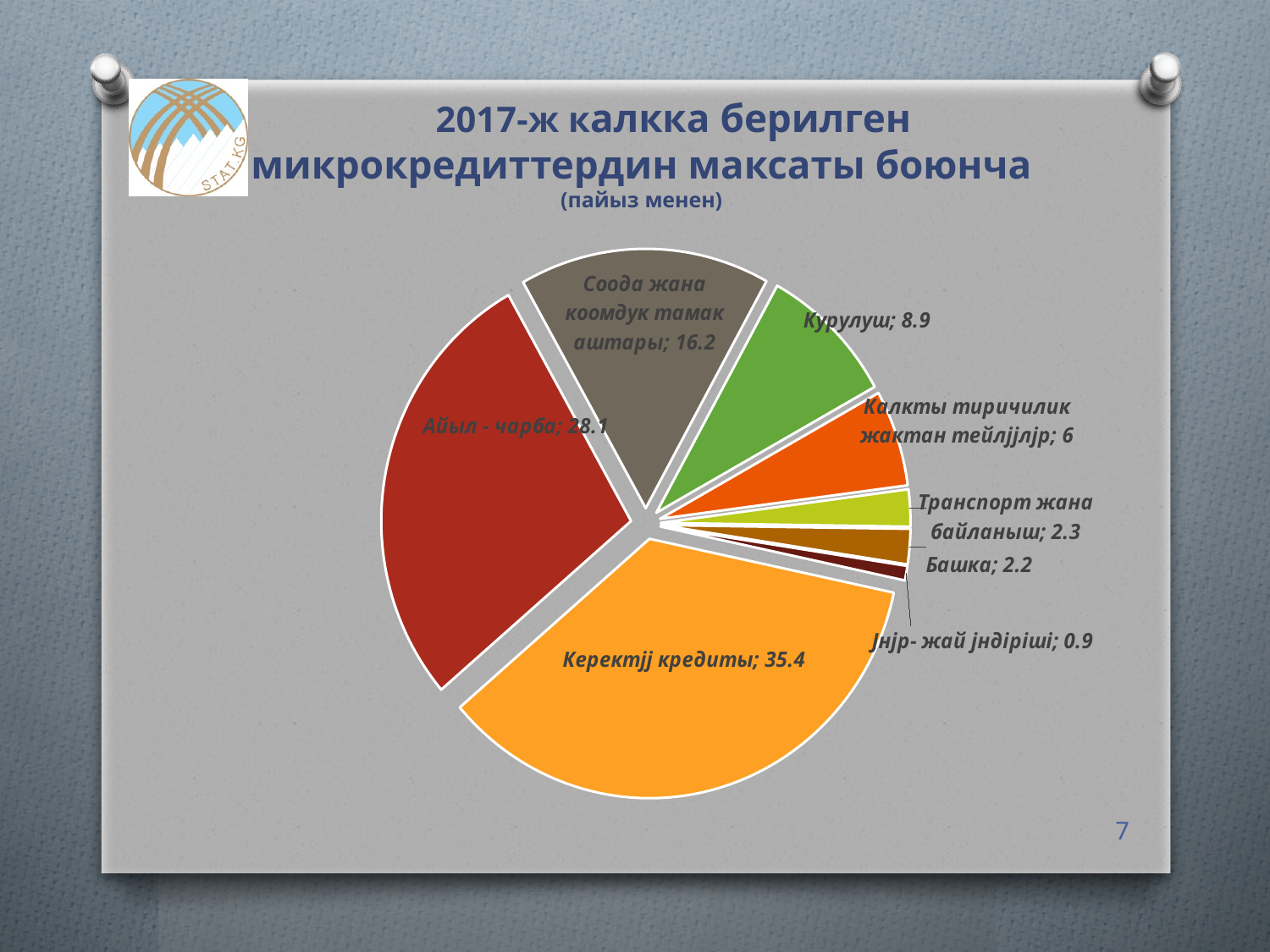
What is the difference between the values for Транспорт жана байланыш and Башка? 0.1 What is the value for Айыл - чарба? 28.1 What is the difference between the values for Керектјј кредиты and Айыл - чарба? 7.3 What is the value for Соода жана коомдук тамак аштары? 16.2 What is the value for Транспорт жана байланыш? 2.3 How many slices does the pie chart have? 8 What year is mentioned in the chart title? 2017 Which category has the largest slice of the pie? Керектјј кредиты Which is larger, the value for Курулуш or the value for Башка? Курулуш What kind of chart is shown on the slide? pie chart Which category has the smallest slice of the pie? Јнјр- жай јндіріші What is the value for Курулуш? 8.9